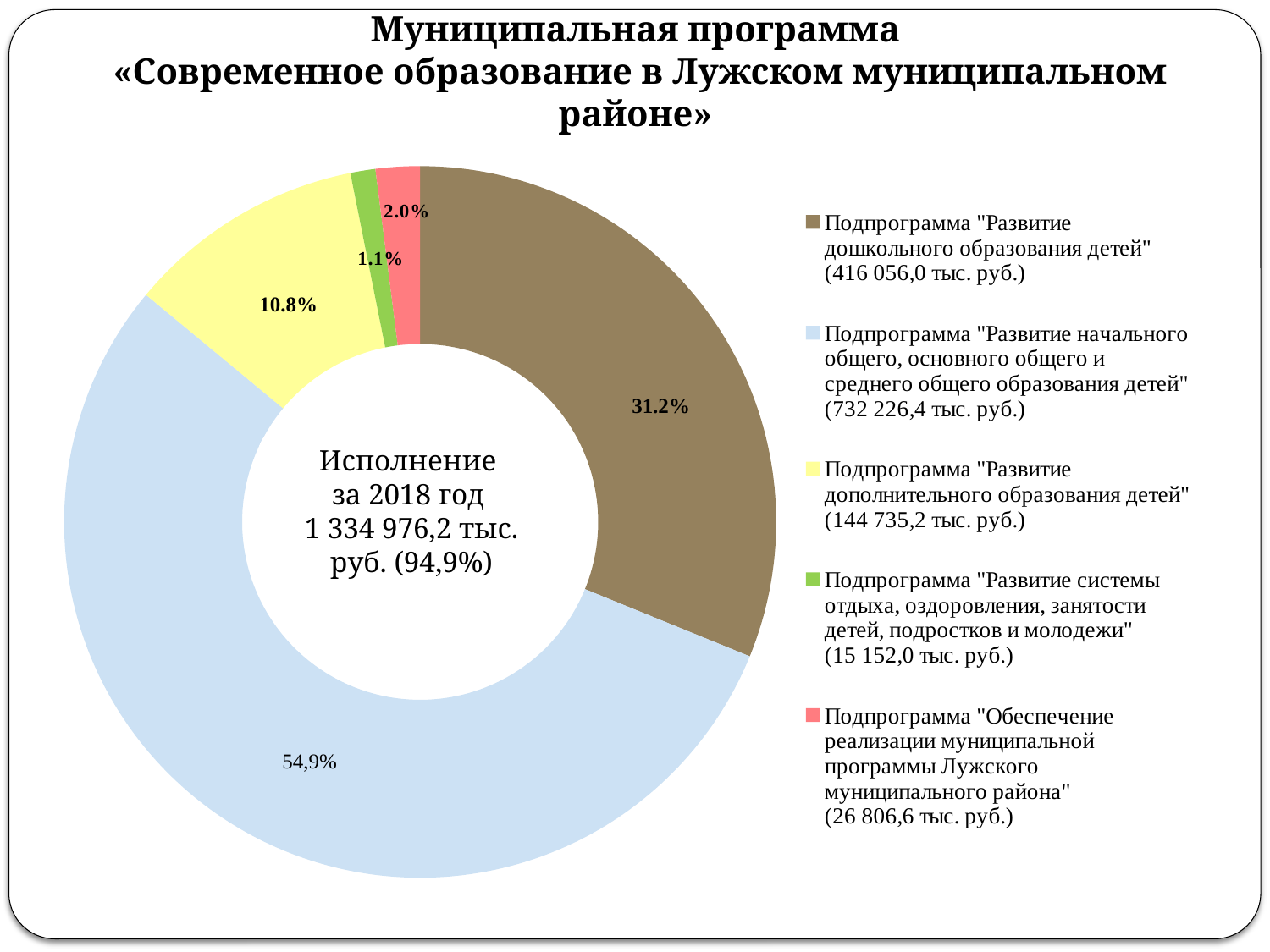
What is the difference in thousand rubles between the subprogramme "Развитие начального общего, основного общего и среднего общего образования детей" (732 226,4) and the subprogramme "Развитие дошкольного образования детей" (416 056,0)? 316 170,4 тыс. руб. What share of the pie does the subprogramme "Обеспечение реализации муниципальной программы Лужского муниципального района" hold? 2.0% Which subprogramme has the smallest slice of the pie? Подпрограмма "Развитие системы отдыха, оздоровления, занятости детей, подростков и молодежи" What share of the pie does the subprogramme "Развитие системы отдыха, оздоровления, занятости детей, подростков и молодежи" hold? 1.1% Which subprogramme has the largest slice of the pie? Подпрограмма "Развитие начального общего, основного общего и среднего общего образования детей" How many subprogrammes (slices) does the chart show? 5 What share of the pie does the subprogramme "Развитие начального общего, основного общего и среднего общего образования детей" hold? 54,9% Which slice is larger: the subprogramme "Развитие дошкольного образования детей" or the subprogramme "Развитие дополнительного образования детей"? Подпрограмма "Развитие дошкольного образования детей" What kind of chart is shown on the slide? Pie chart (doughnut) According to the legend, what amount in thousand rubles corresponds to the subprogramme "Развитие дополнительного образования детей"? 144 735,2 тыс. руб.